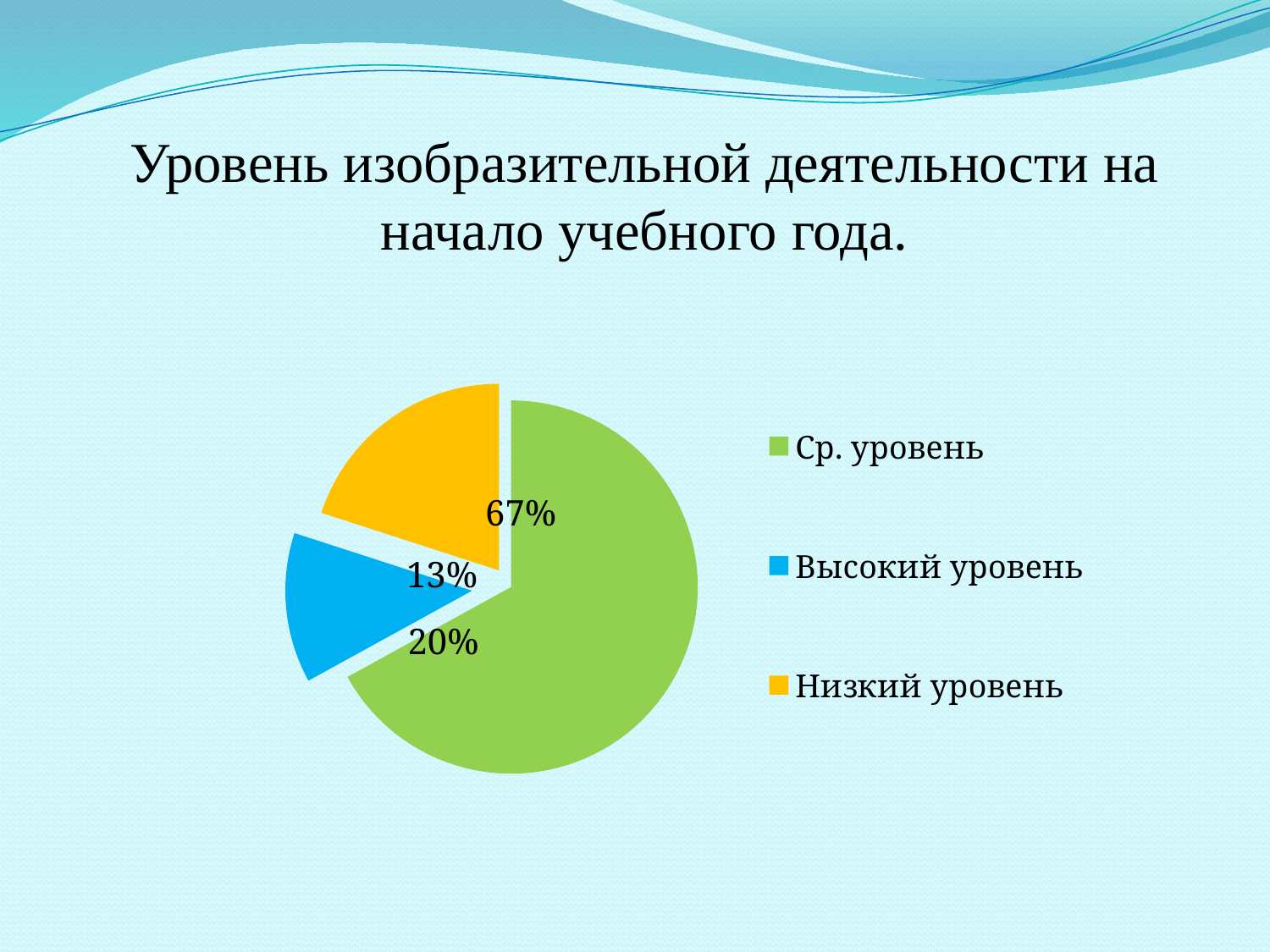
How many entries does the legend list? 3 Which category has the smallest slice of the pie? Высокий уровень Which is larger, the share of Низкий уровень or the share of Высокий уровень? Низкий уровень What is the title of the chart on the slide? Уровень изобразительной деятельности на начало учебного года. Which category has the largest slice of the pie? Ср. уровень What colour is the slice for Ср. уровень? green How many slices does the pie chart have? 3 What share of the pie is Низкий уровень? 20% What kind of chart is shown on the slide? pie chart What share of the pie is Ср. уровень? 67% What is the difference between the shares of Ср. уровень and Низкий уровень? 47% What share of the pie is Высокий уровень? 13%